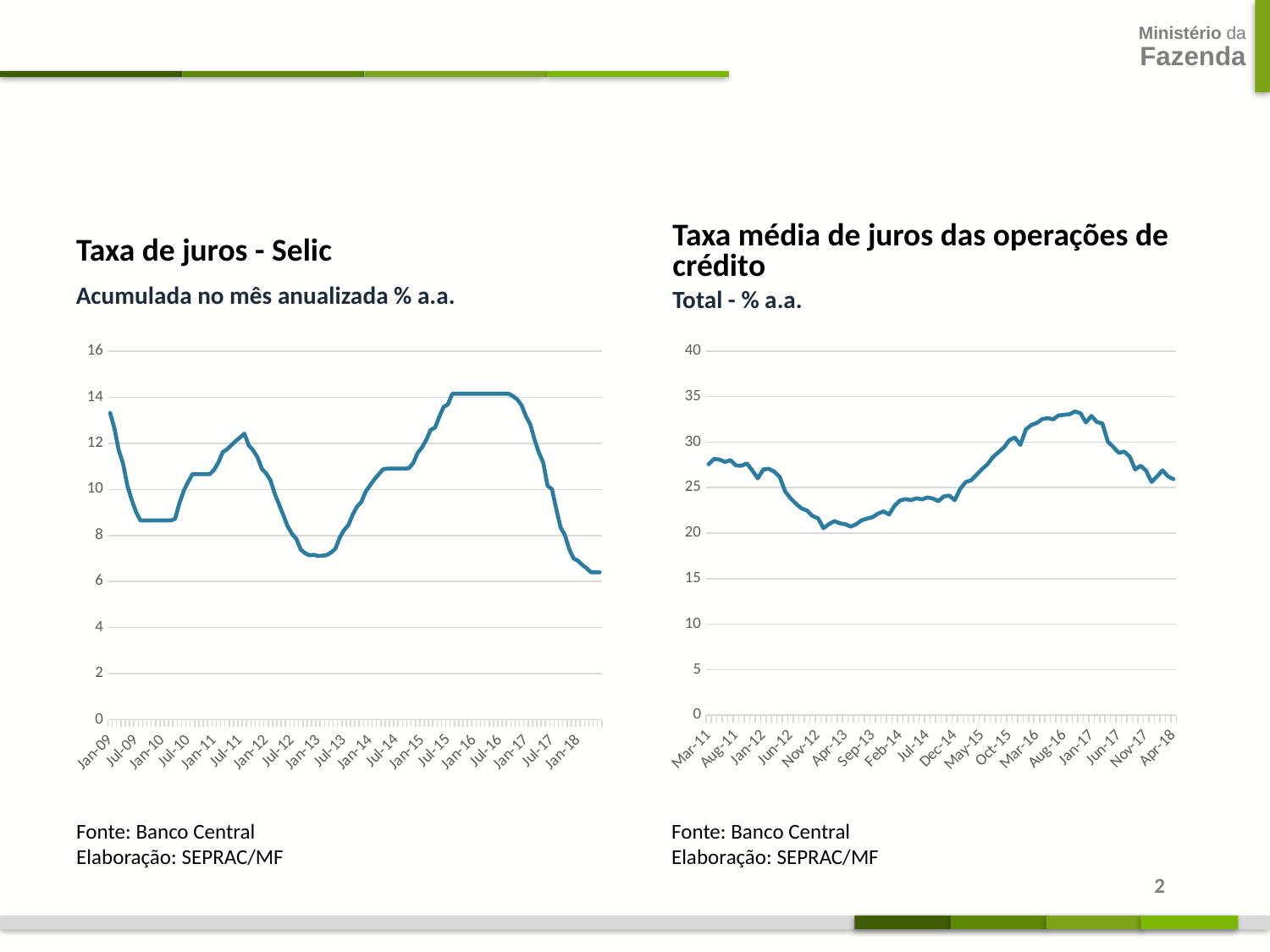
What is the subtitle shown under the 'Taxa de juros - Selic' chart title? Acumulada no mês anualizada % a.a. In the 'Taxa média de juros das operações de crédito' chart, does the line rise or fall between Apr-13 and Jan-17? rise In the 'Taxa de juros - Selic' chart, is the value at Jan-13 greater or less than 8? less What kind of chart is the 'Taxa de juros - Selic' chart on the left? line chart What kind of chart is the 'Taxa média de juros das operações de crédito' chart on the right? line chart In the 'Taxa de juros - Selic' chart, is the value at Jan-18 greater or less than 8? less In the 'Taxa média de juros das operações de crédito' chart, is the value at Mar-11 greater or less than 25? greater In the 'Taxa de juros - Selic' chart, does the line rise or fall between Jan-17 and Jan-18? fall What source is cited for the 'Taxa média de juros das operações de crédito' chart? Banco Central